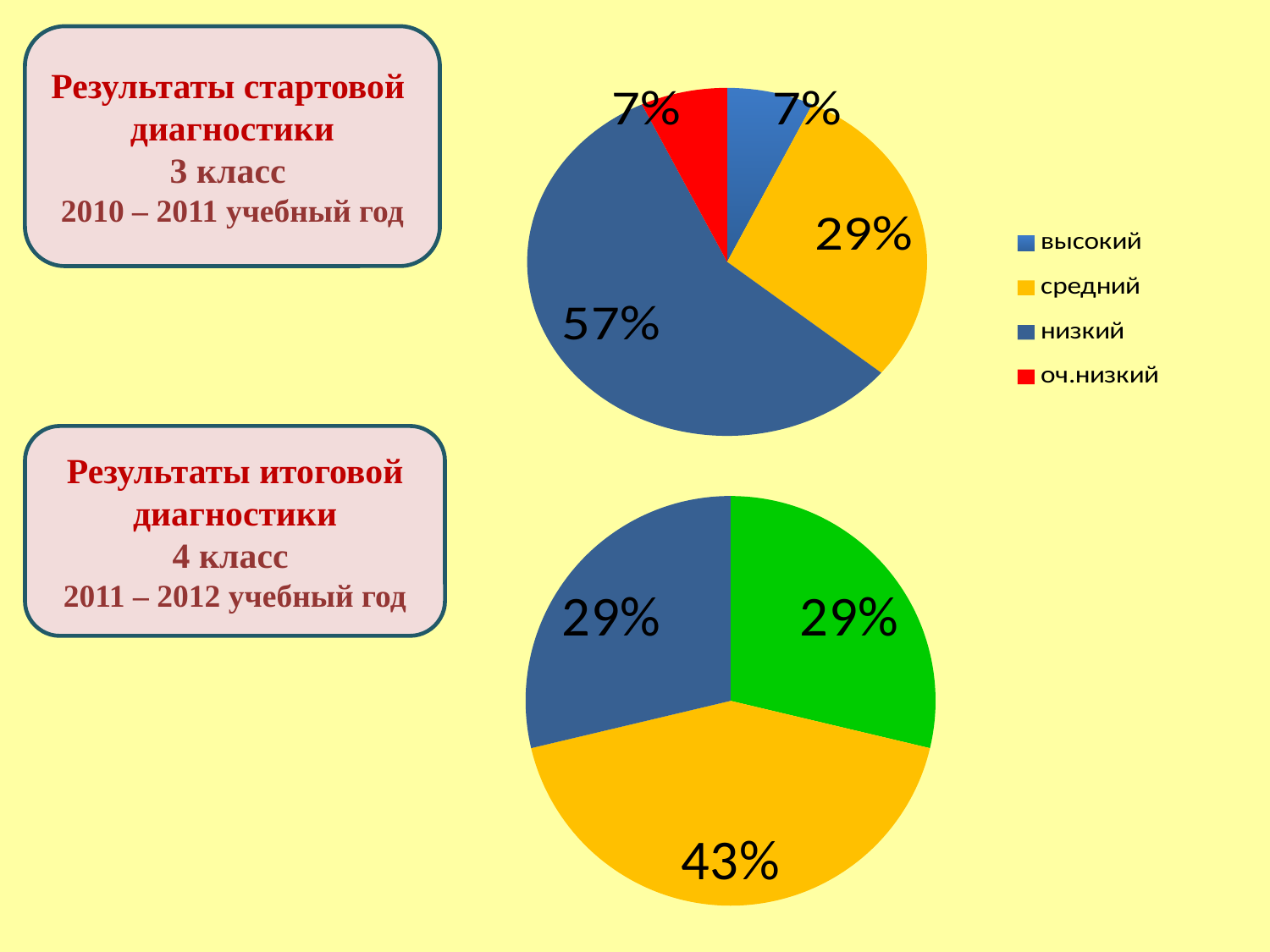
On the top pie chart (Результаты стартовой диагностики, 3 класс), what percentage is shown for высокий? 7% On the bottom pie chart (Результаты итоговой диагностики, 4 класс), what percentage is shown on the yellow slice? 43% On the top pie chart (Результаты стартовой диагностики, 3 класс), what percentage is shown for низкий? 57% What type of chart is used for Результаты стартовой диагностики, 3 класс? pie chart On the bottom pie chart (Результаты итоговой диагностики, 4 класс), how many slices are there? 3 On the top pie chart (Результаты стартовой диагностики, 3 класс), which category has the largest share? низкий On the bottom pie chart (Результаты итоговой диагностики, 4 класс), what is the largest percentage shown? 43% On the top pie chart (Результаты стартовой диагностики, 3 класс), which is larger: средний or оч.низкий? средний On the top pie chart (Результаты стартовой диагностики, 3 класс), what percentage is shown for средний? 29% On the top pie chart (Результаты стартовой диагностики, 3 класс), what is the difference in percentage points between низкий and средний? 28 On the top pie chart (Результаты стартовой диагностики, 3 класс), what colour represents оч.низкий in the legend? red How many entries does the legend of the top pie chart (Результаты стартовой диагностики, 3 класс) list? 4